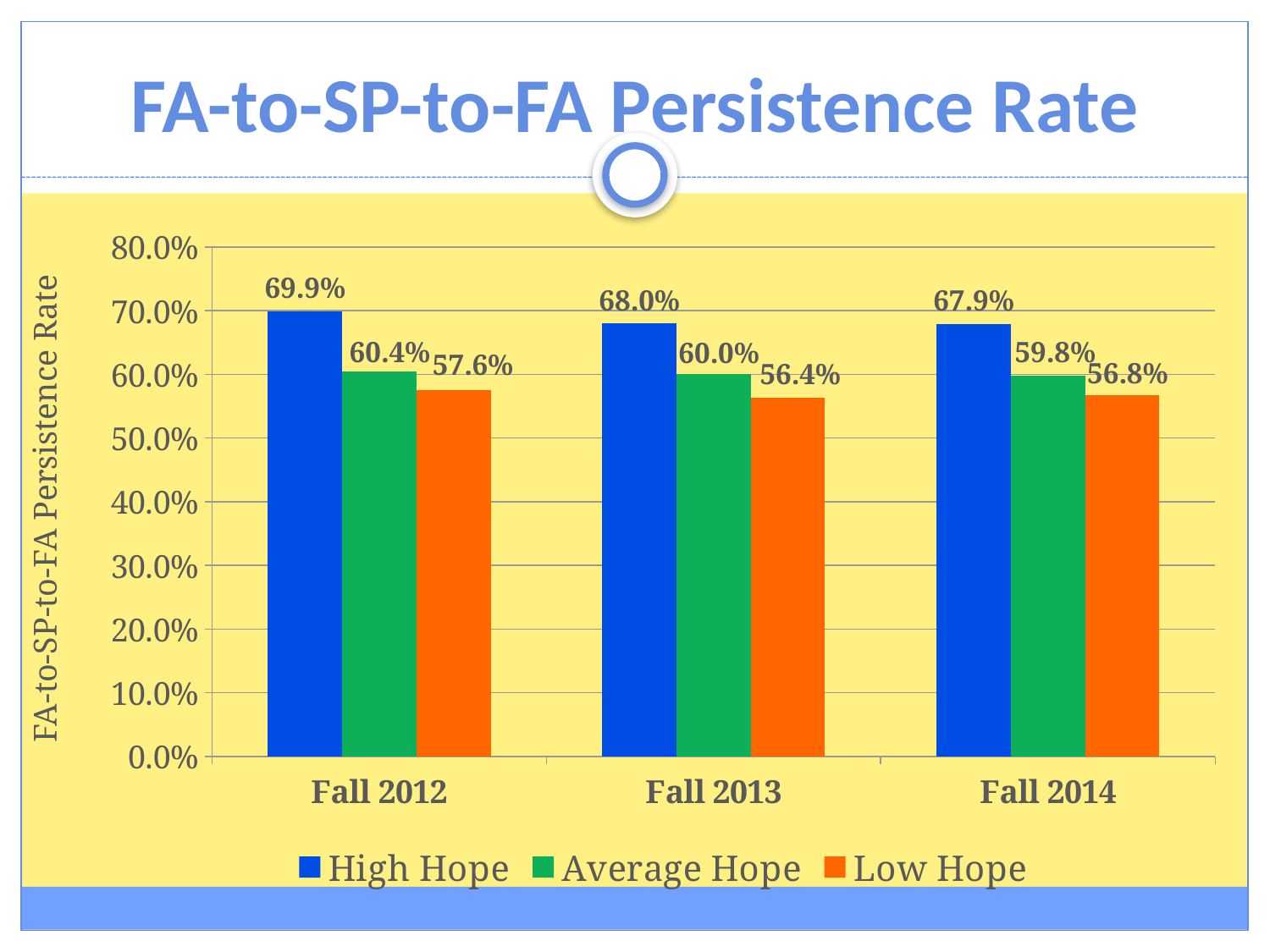
What is the FA-to-SP-to-FA persistence rate for High Hope students in Fall 2012? 69.9% Does the High Hope persistence rate rise or fall from Fall 2012 to Fall 2014? Fall How many fall terms are shown on the x axis? 3 Which hope group has the highest persistence rate in Fall 2014? High Hope What is the persistence rate for Average Hope students in Fall 2014? 59.8% What is the difference between the High Hope and Low Hope persistence rates in Fall 2012? 12.3% What is the difference between the Average Hope and Low Hope persistence rates in Fall 2013? 3.6% Which hope group has the lowest persistence rate in Fall 2012? Low Hope What is the persistence rate for Low Hope students in Fall 2013? 56.4% Which is larger: the High Hope rate in Fall 2013 or the High Hope rate in Fall 2012? Fall 2012 How many series does the legend list? 3 What kind of chart is shown on the slide? Bar chart